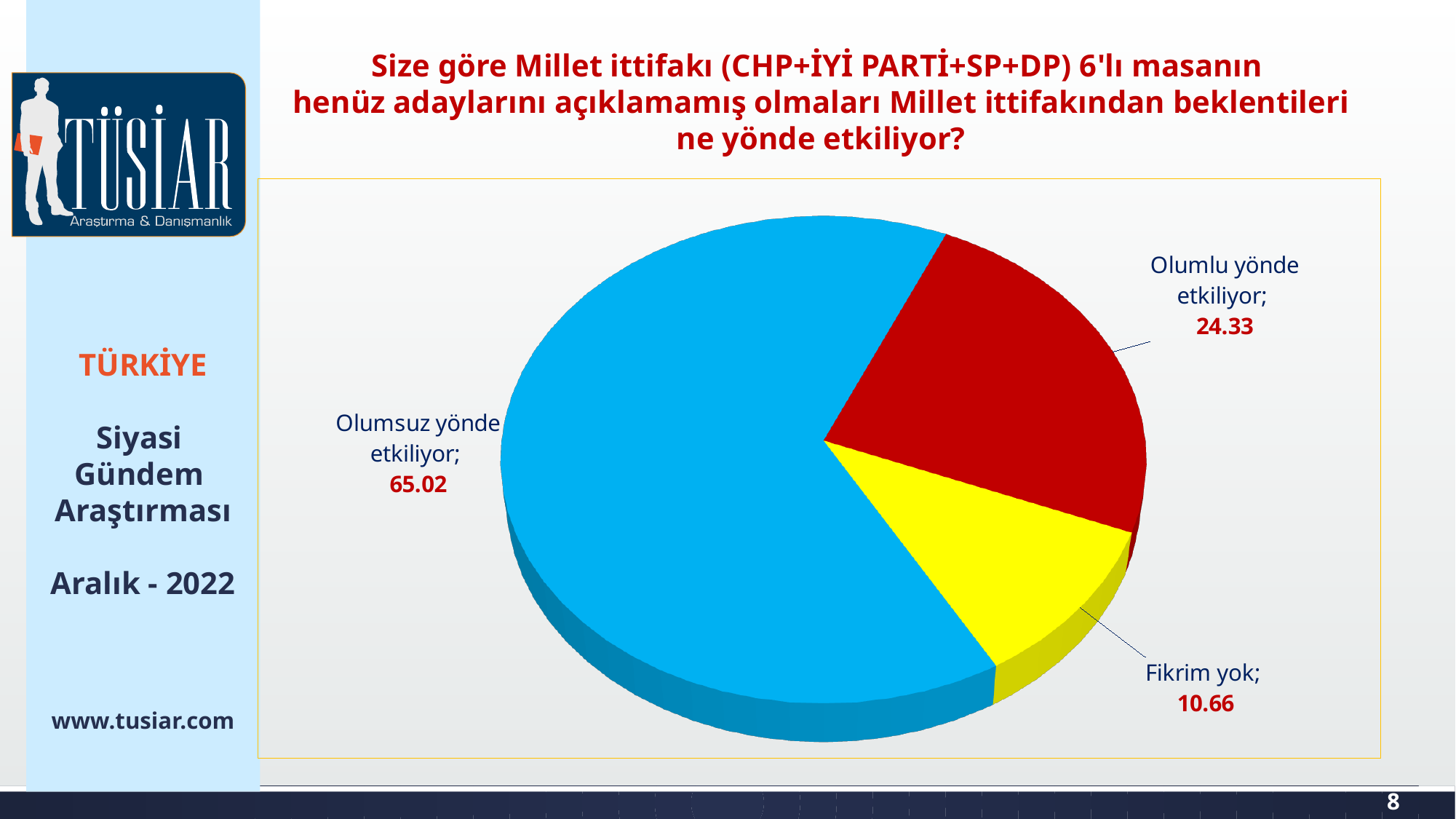
Which category has the smallest slice of the pie? Fikrim yok How many categories (slices) does the pie chart have? 3 What kind of chart is shown on the slide? Pie chart Which category has the largest slice of the pie? Olumsuz yönde etkiliyor What value is shown for "Olumlu yönde etkiliyor"? 24.33 What is the difference between the values for "Olumlu yönde etkiliyor" and "Fikrim yok"? 13.67 What colour is the slice for "Fikrim yok"? Yellow What value is shown for "Olumsuz yönde etkiliyor"? 65.02 What colour is the slice for "Olumlu yönde etkiliyor"? Red Which is larger, the value for "Olumlu yönde etkiliyor" or the value for "Fikrim yok"? Olumlu yönde etkiliyor What value is shown for "Fikrim yok"? 10.66 What is the difference between the values for "Olumsuz yönde etkiliyor" and "Olumlu yönde etkiliyor"? 40.69